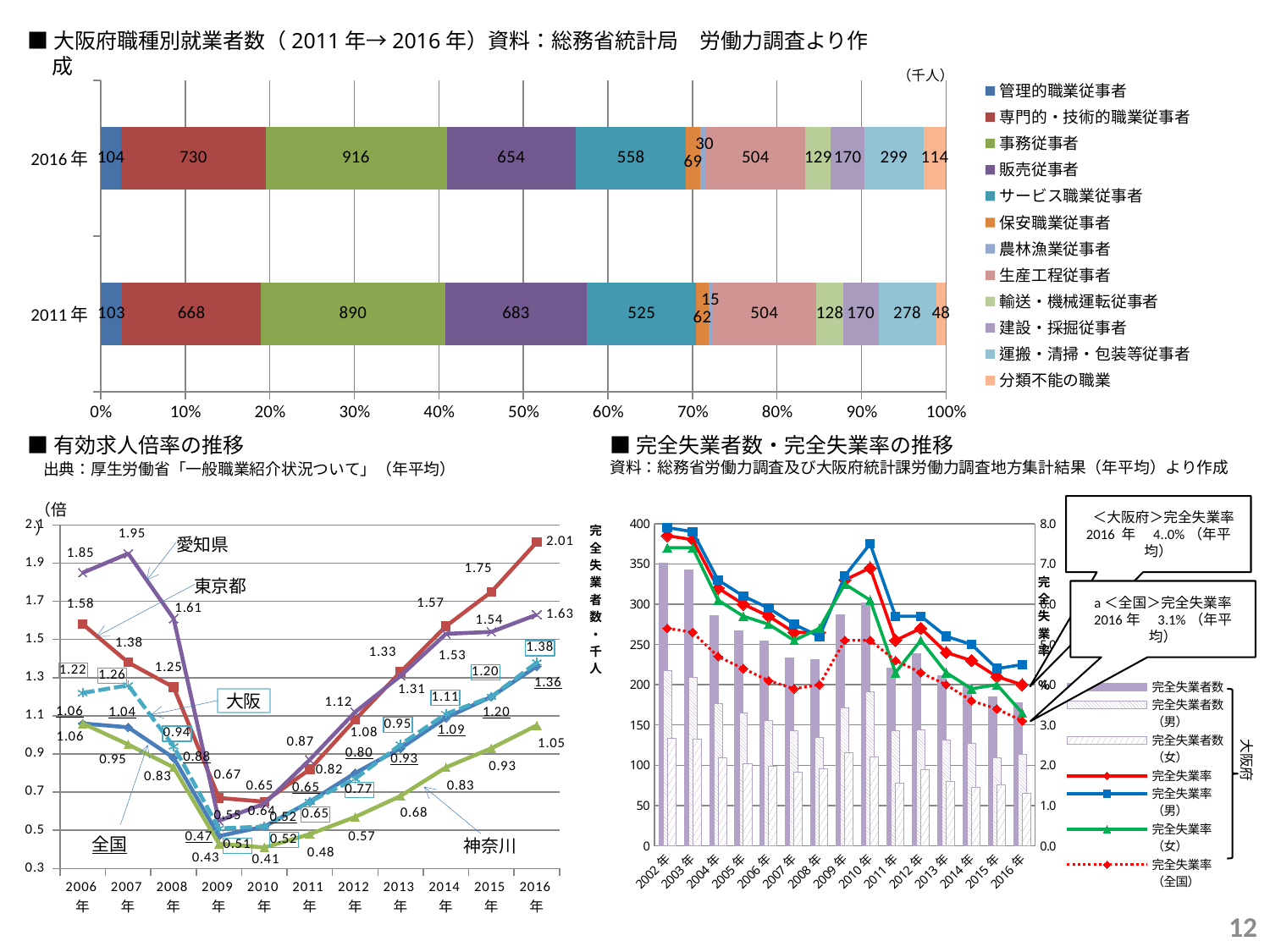
In the 有効求人倍率の推移 chart, how many years are shown on the x axis? 11 How many series does the legend of the 完全失業者数・完全失業率の推移 chart list? 7 What kind of chart is the 大阪府職種別就業者数 chart? Stacked bar chart In the 有効求人倍率の推移 chart, which series has the highest value in 2016年? 東京都 In the 大阪府職種別就業者数 chart, what is the value for 事務従事者 in 2016年? 916 In the 大阪府職種別就業者数 chart, which year has the larger value for 販売従事者, 2016年 or 2011年? 2011年 In the 有効求人倍率の推移 chart, does the 大阪 line rise or fall from 2009年 to 2016年? Rises In the 大阪府職種別就業者数 chart, what is the value for 専門的・技術的職業従事者 in 2011年? 668 How many series does the legend of the 大阪府職種別就業者数 chart list? 12 In the 有効求人倍率の推移 chart, what is the value for 大阪 in 2016年? 1.38 In the 有効求人倍率の推移 chart, what is the value for 愛知県 in 2007年? 1.95 In the 大阪府職種別就業者数 chart, what is the difference between the 事務従事者 values for 2016年 and 2011年? 26